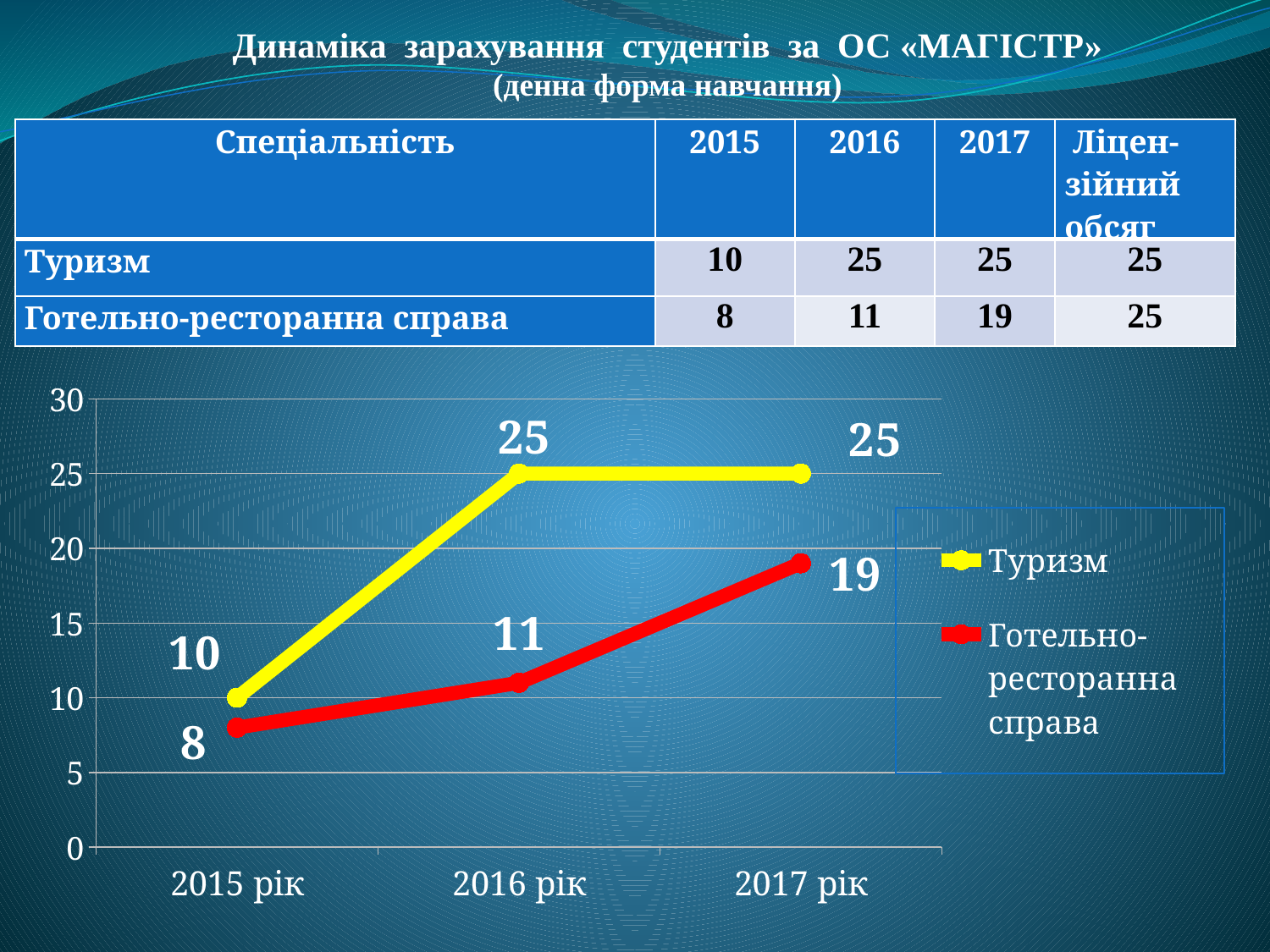
In which year is the value for Готельно-ресторанна справа lowest? 2015 рік Which series has the larger value in 2016 рік, Туризм or Готельно-ресторанна справа? Туризм How many points are plotted along the x axis for each series? 3 Which colour is used for the Туризм line? yellow What is the value for Готельно-ресторанна справа in 2016 рік? 11 What is the value for Готельно-ресторанна справа in 2017 рік? 19 How many series does the chart legend list? 2 Is the value for Туризм in 2016 рік greater or less than 20? greater What is the value for Туризм in 2015 рік? 10 What type of chart is shown on the slide? line chart What is the difference between Туризм and Готельно-ресторанна справа in 2017 рік? 6 Does the value for Готельно-ресторанна справа rise or fall from 2015 рік to 2017 рік? rise